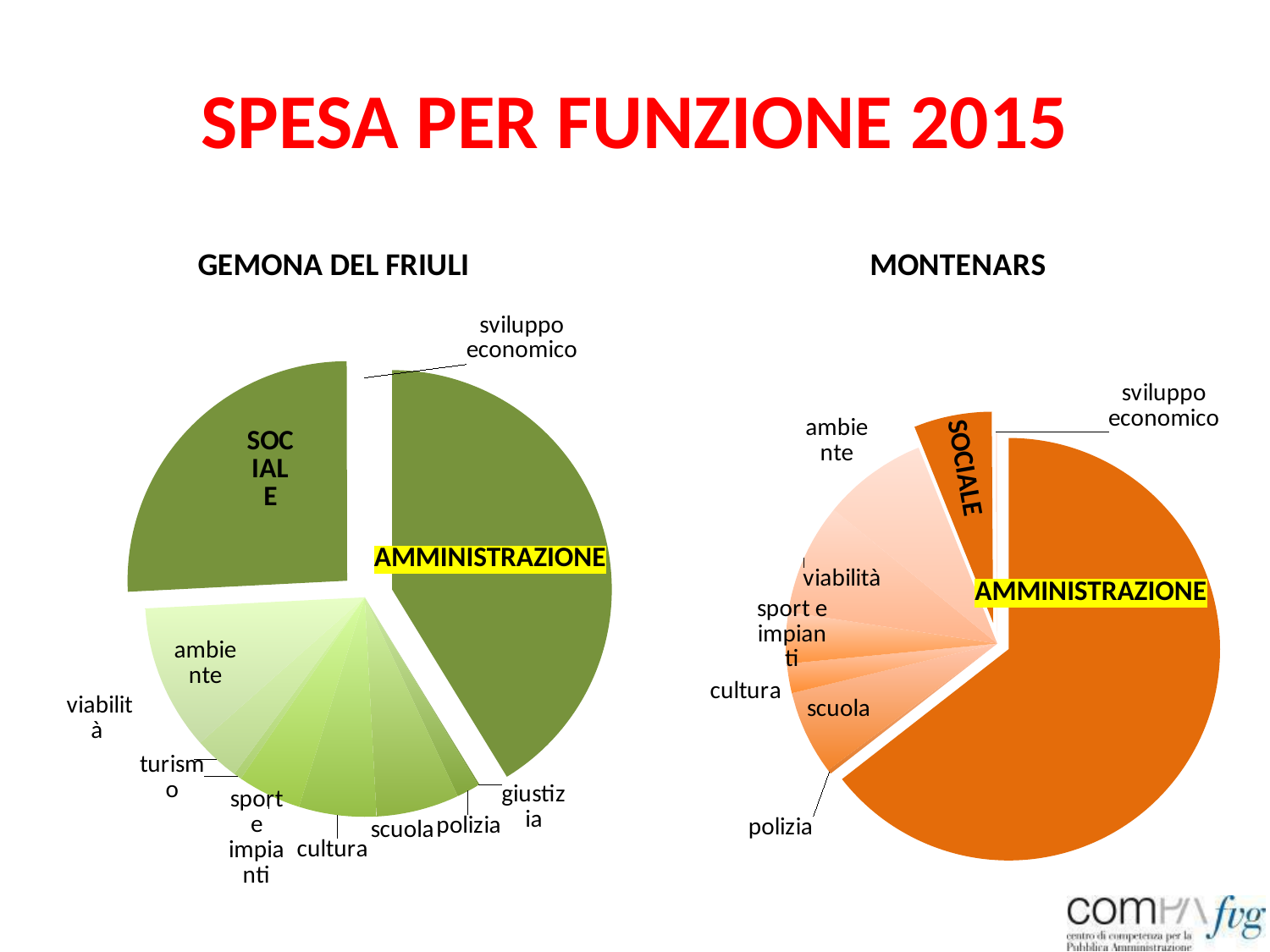
How many labelled categories does the GEMONA DEL FRIULI pie chart show? 11 In the MONTENARS chart, which slice is larger, AMMINISTRAZIONE or SOCIALE? AMMINISTRAZIONE What is the title of the slide? SPESA PER FUNZIONE 2015 In the GEMONA DEL FRIULI chart, which slice is larger, AMMINISTRAZIONE or SOCIALE? AMMINISTRAZIONE In the MONTENARS chart, which category has the smallest slice? sviluppo economico In the GEMONA DEL FRIULI chart, which slice is larger, SOCIALE or ambiente? SOCIALE What kind of chart is used for GEMONA DEL FRIULI? Pie chart What colour scheme is used for the MONTENARS pie chart? Orange What kind of chart is used for MONTENARS? Pie chart In the MONTENARS chart, which category has the largest slice? AMMINISTRAZIONE In the GEMONA DEL FRIULI chart, which category has the smallest slice? sviluppo economico In the GEMONA DEL FRIULI chart, which category has the largest slice? AMMINISTRAZIONE